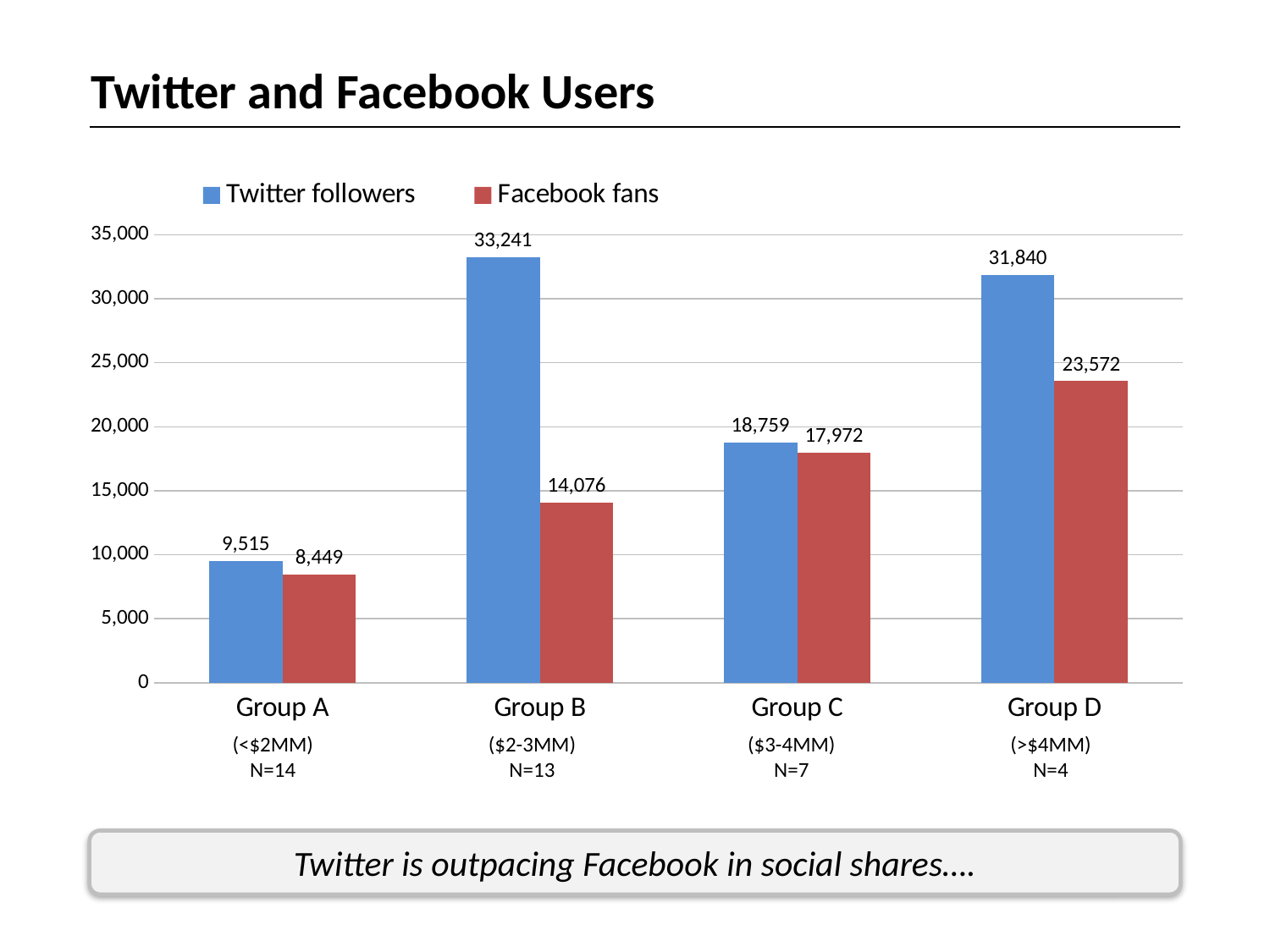
Which group has the highest number of Twitter followers? Group B How many series does the legend list? 2 Which group has the lowest number of Facebook fans? Group A Which is larger for Group C: Twitter followers or Facebook fans? Twitter followers How many Facebook fans does Group A have? 8,449 What kind of chart is shown on the slide? Bar chart How many Facebook fans does Group D have? 23,572 How many Twitter followers does Group B have? 33,241 What is the title of the slide? Twitter and Facebook Users What is the difference between Twitter followers and Facebook fans for Group B? 19,165 What is the difference between Twitter followers and Facebook fans for Group D? 8,268 How many groups are shown on the x axis? 4